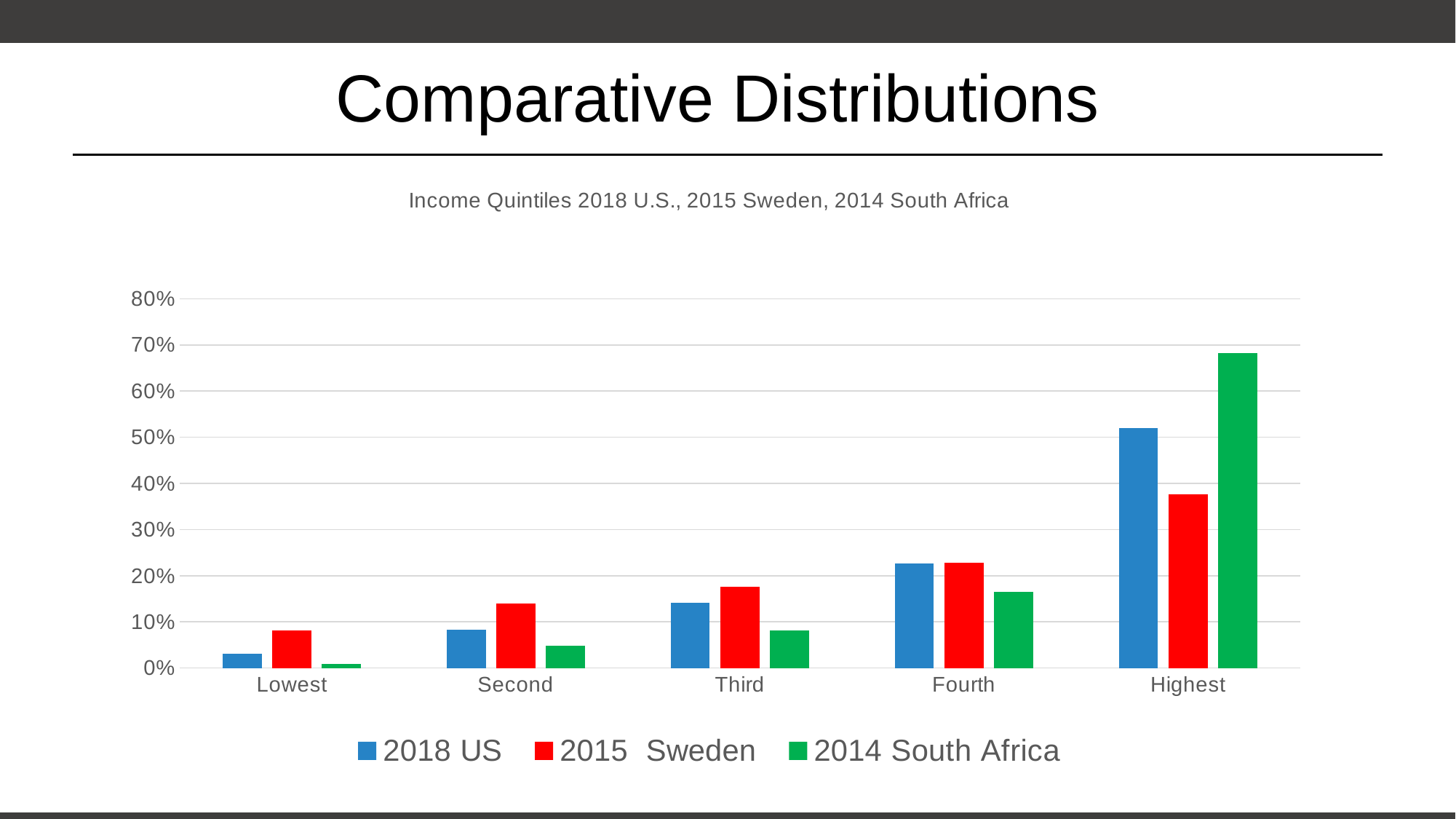
Is the value for 2018 US in the Highest quintile greater or less than 50%? greater Which quintile has the lowest value for 2018 US? Lowest How many series does the legend list? 3 Do the values for 2018 US rise or fall from the Lowest quintile to the Highest quintile? rise What colour represents the 2014 South Africa series? green Which quintile has the highest value for 2014 South Africa? Highest What kind of chart is shown on the slide? bar chart Is the value for 2014 South Africa in the Highest quintile greater or less than 60%? greater How many income quintile categories are shown on the x axis? 5 In the Lowest quintile, which series has the larger value: 2015 Sweden or 2014 South Africa? 2015 Sweden In the Highest quintile, which series has the larger value: 2018 US or 2015 Sweden? 2018 US Is the value for 2015 Sweden in the Highest quintile greater or less than 40%? less